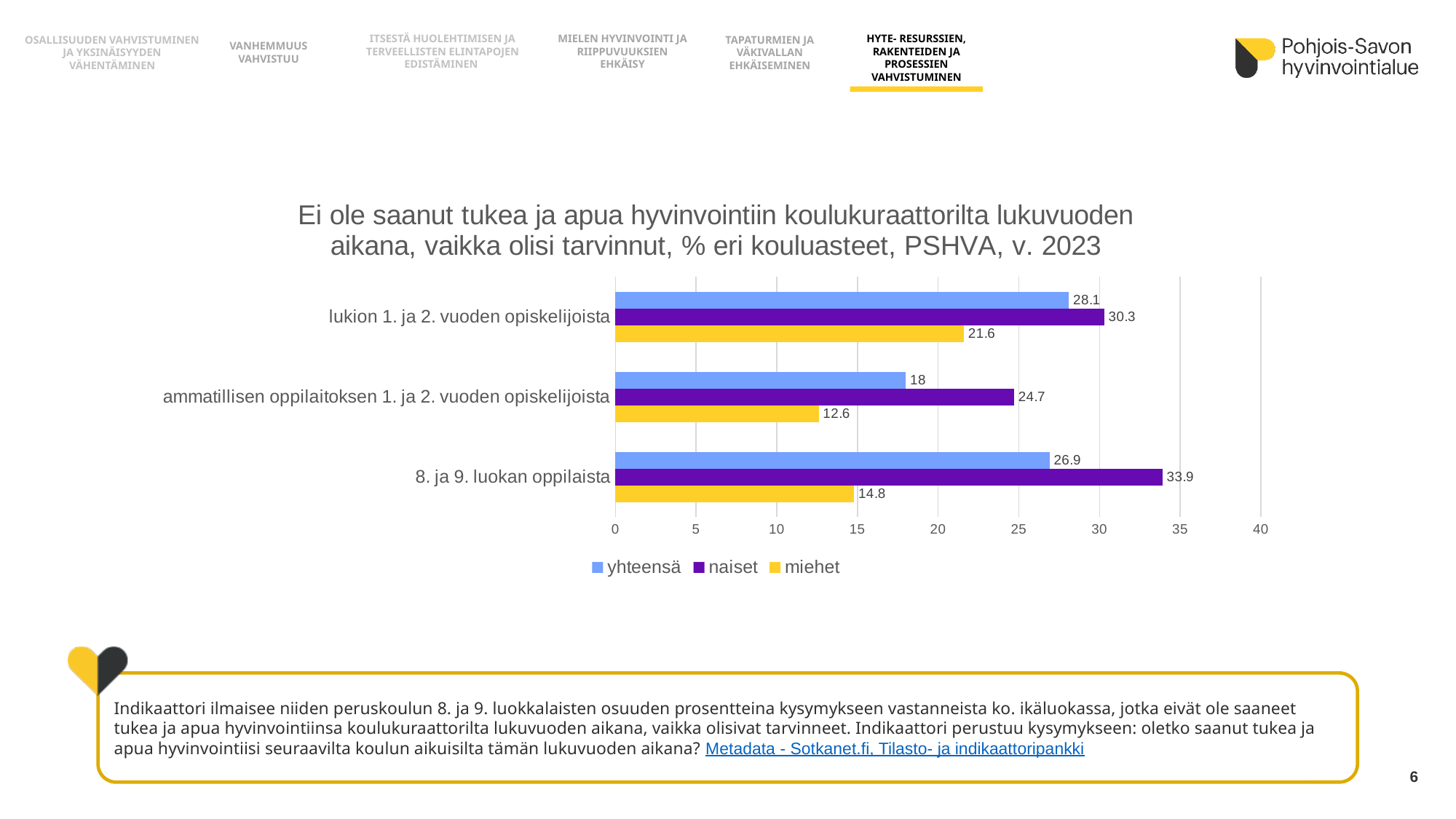
What is the difference between the naiset and miehet values for 8. ja 9. luokan oppilaista? 19.1 How many categories are shown on the y axis of the chart? 3 What is the yhteensä value for lukion 1. ja 2. vuoden opiskelijoista? 28.1 What kind of chart is shown on the slide? bar chart What is the value for naiset among 8. ja 9. luokan oppilaista? 33.9 Which colour represents the miehet series in the chart? yellow What is the value for miehet among ammatillisen oppilaitoksen 1. ja 2. vuoden opiskelijoista? 12.6 Which category has the highest naiset value? 8. ja 9. luokan oppilaista How many series does the legend list? 3 Is the yhteensä value for ammatillisen oppilaitoksen 1. ja 2. vuoden opiskelijoista greater or less than 20? less Which is larger for lukion 1. ja 2. vuoden opiskelijoista: the naiset value or the miehet value? naiset Which category has the lowest miehet value? ammatillisen oppilaitoksen 1. ja 2. vuoden opiskelijoista